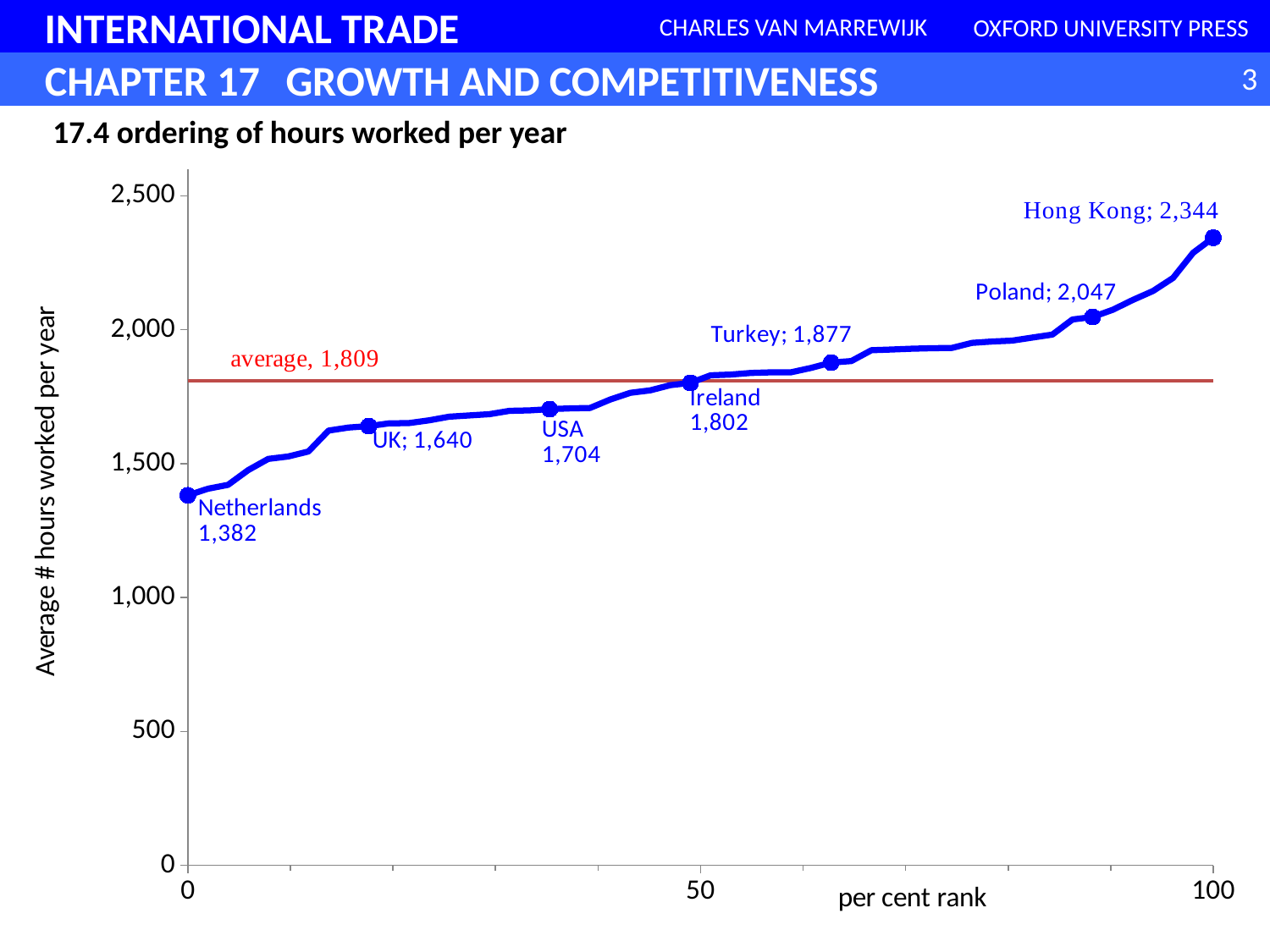
What is the difference between the values for Turkey and Ireland? 75 What is the difference between the values for Hong Kong and the Netherlands? 962 What kind of chart is shown on the slide? line chart Which labelled country has the lowest average hours worked per year? Netherlands Do the values rise or fall as the per cent rank increases along the x axis? rise Which has a higher value, the USA or the UK? USA What is the value of the average line shown on the chart? 1,809 What is the average number of hours worked per year for Hong Kong? 2,344 Is the value for Ireland greater or less than 2,000? less What value is shown for Poland? 2,047 What is the average number of hours worked per year for the Netherlands? 1,382 Which labelled country has the highest average hours worked per year? Hong Kong